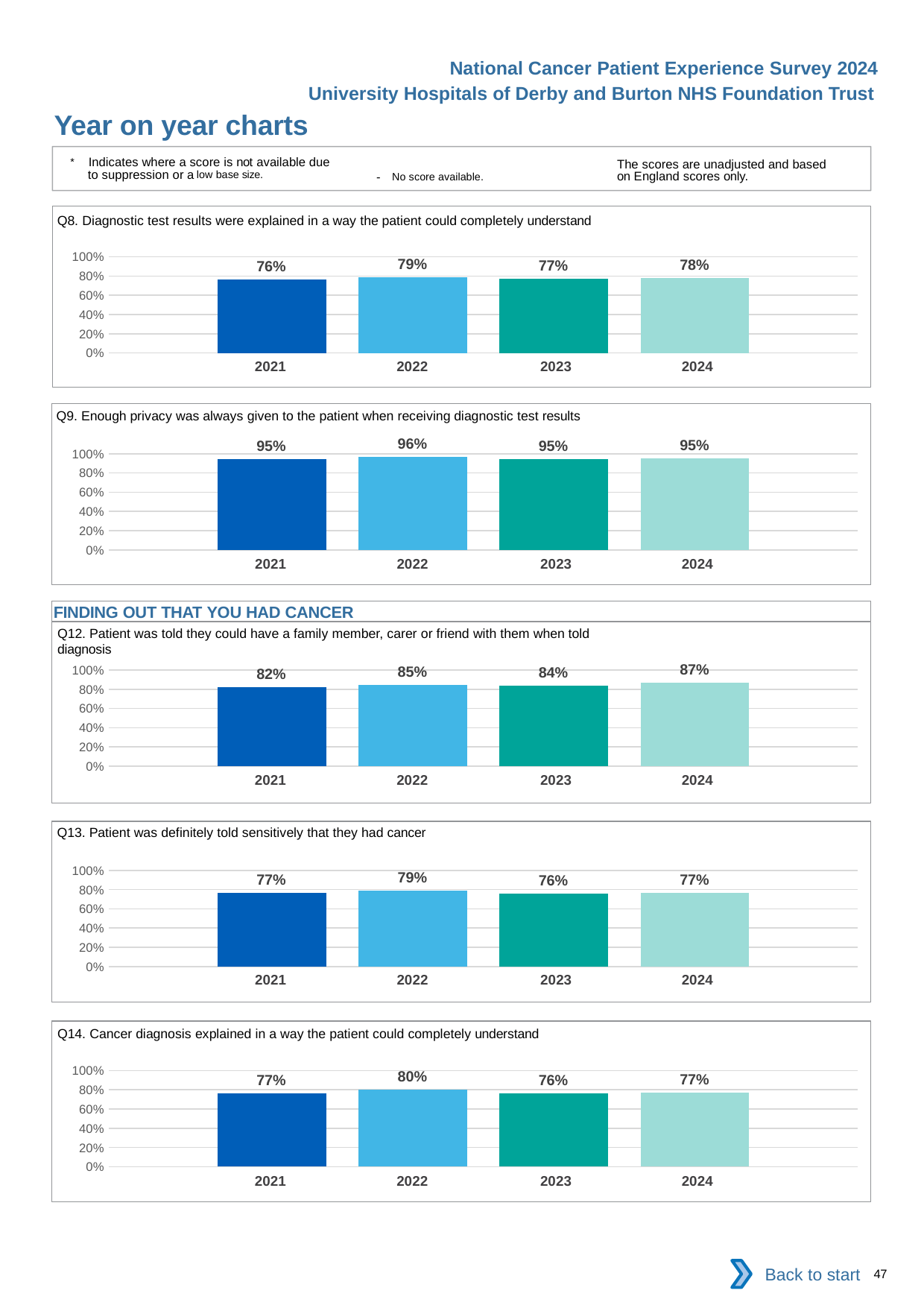
In the Q8 chart, which year has the lowest value? 2021 What type of chart is the Q9 chart? Bar chart In the Q12 chart (Patient was told they could have a family member, carer or friend with them when told diagnosis), what is the difference between the 2024 and 2021 values? 5% In the Q9 chart, which year has the highest value? 2022 In the Q12 chart, which year has the highest value? 2024 In the Q14 chart (Cancer diagnosis explained in a way the patient could completely understand), what is the value for 2022? 80% In the Q9 chart (Enough privacy was always given to the patient when receiving diagnostic test results), what is the value for 2024? 95% In the Q13 chart (Patient was definitely told sensitively that they had cancer), what is the value for 2023? 76% How many years are shown on the x axis of the Q8 chart? 4 In the Q14 chart, what is the difference between the 2022 and 2023 values? 4% In the Q8 chart (Diagnostic test results were explained in a way the patient could completely understand), what is the value for 2022? 79% In the Q13 chart, which is larger, the value for 2022 or the value for 2024? 2022